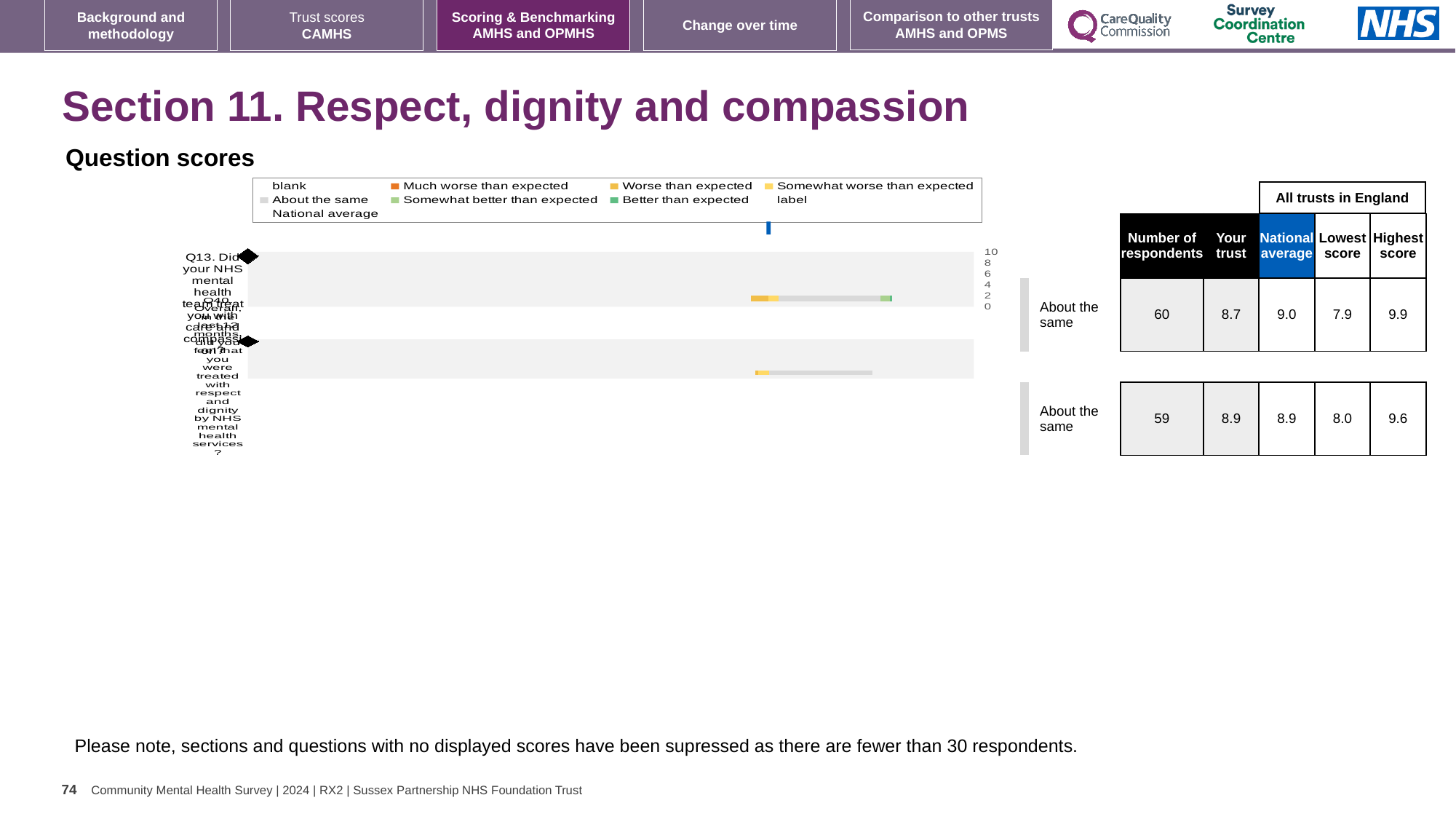
In the table next to the chart, what is the lowest score for the first row? 7.9 What kind of chart is shown under 'Question scores'? bar chart In the table next to the chart, what is the 'Your trust' score for the second row? 8.9 How many question rows (categories) are plotted in the 'Question scores' chart? 2 In the table next to the chart, what is the number of respondents for the first row? 60 What benchmark category is shown beside the first row of the chart? About the same In the table, is the number of respondents for the second row greater or less than 60? less In the table next to the chart, what is the highest score for the second row? 9.6 In the table, what is the difference between the highest score and the lowest score for the first row? 2.0 In the table next to the chart, what is the national average for the first row? 9.0 In the table, which row has the higher 'Your trust' score, the first row (8.7) or the second row (8.9)? second row What is the highest tick value shown on the chart's numeric axis? 10